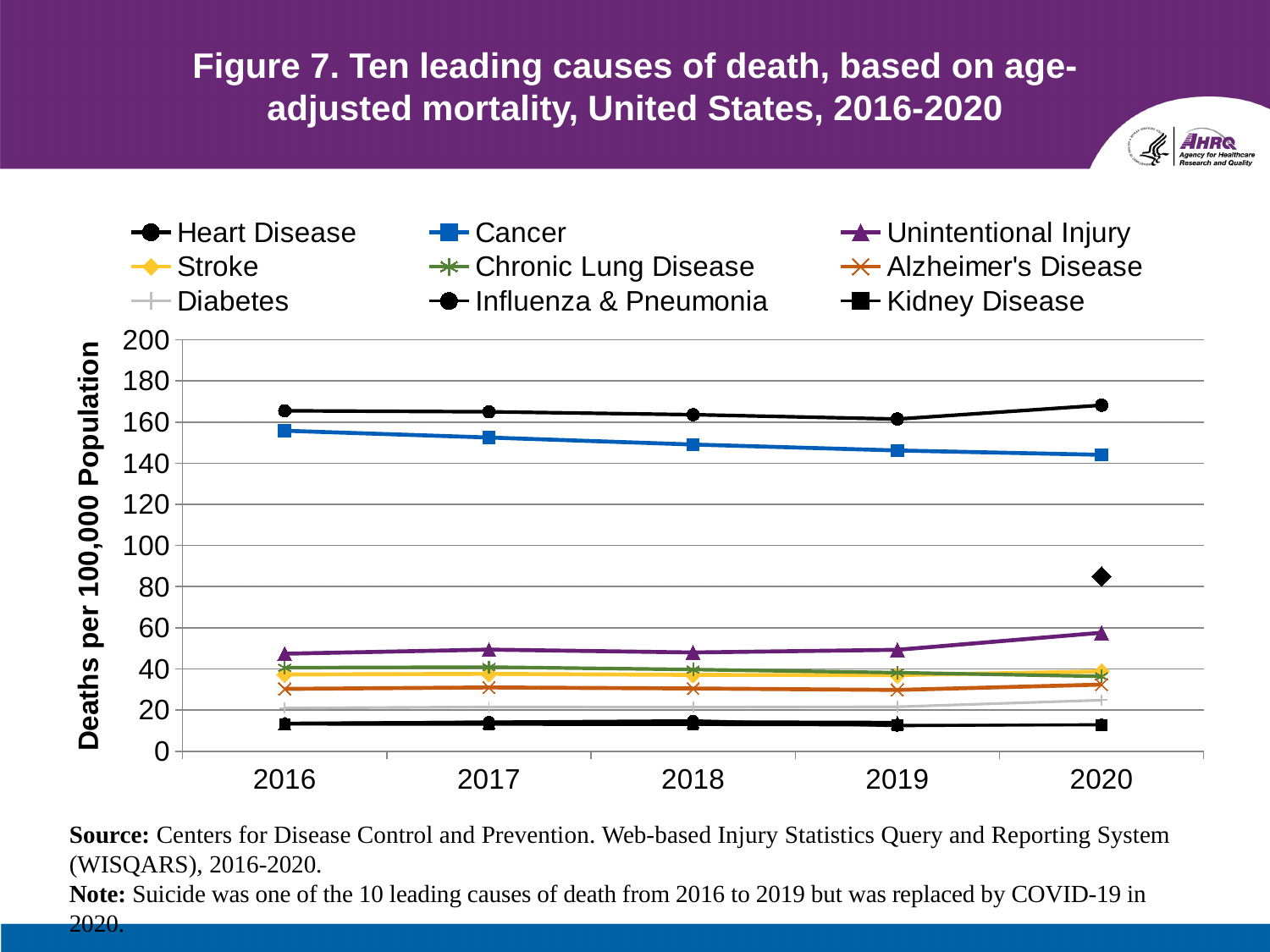
Does the Cancer line rise or fall from 2016 to 2020? fall Is the value for Cancer in 2020 greater or less than 160? less In 2020, which is higher: Unintentional Injury or Stroke? Unintentional Injury Is the value for Heart Disease in 2016 greater or less than 160? greater Is the value for Unintentional Injury in 2020 greater or less than 40? greater How many years are shown along the x axis? 5 What kind of chart is shown on the slide? line chart How many series does the legend list? 9 What is the label of the y axis? Deaths per 100,000 Population In 2020, which is higher: Heart Disease or Cancer? Heart Disease Which cause of death has the highest age-adjusted mortality rate across all years shown? Heart Disease